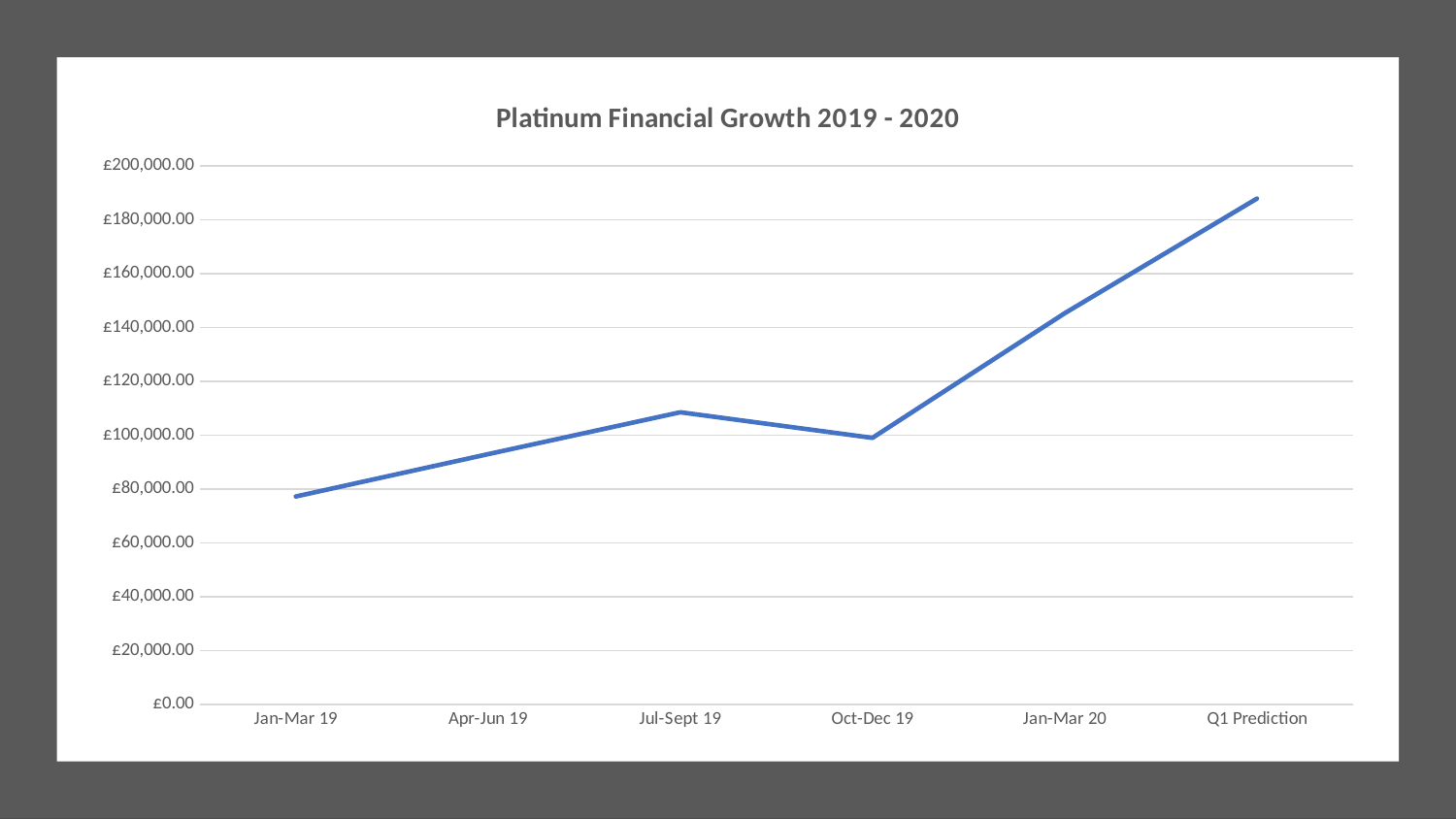
Which is larger, the value for Jul-Sept 19 or the value for Oct-Dec 19? Jul-Sept 19 Is the value for Jan-Mar 20 greater or less than £140,000.00? greater What kind of chart is shown on the slide? Line chart Does the line rise or fall between Oct-Dec 19 and Q1 Prediction? Rise Is the value for Jan-Mar 19 greater or less than £80,000.00? less Is the value for Jul-Sept 19 greater or less than £100,000.00? greater Which category has the highest value? Q1 Prediction Which category has the lowest value? Jan-Mar 19 What is the title of the chart? Platinum Financial Growth 2019 - 2020 How many points are plotted along the x axis? 6